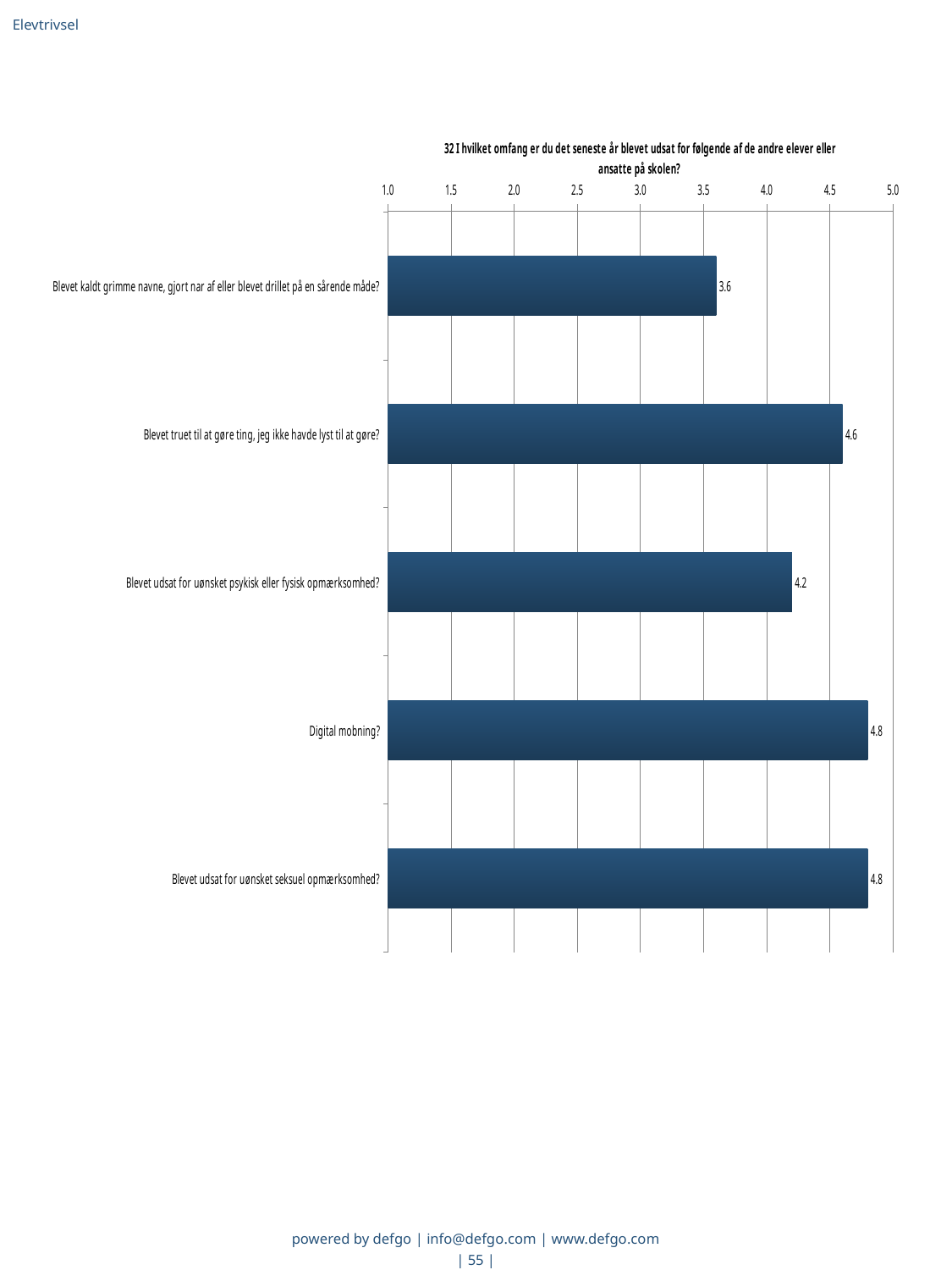
What is the value for "Digital mobning?"? 4.8 How many categories are shown in the chart? 5 Which is larger: the value for "Blevet truet til at gøre ting, jeg ikke havde lyst til at gøre?" or the value for "Blevet udsat for uønsket psykisk eller fysisk opmærksomhed?"? Blevet truet til at gøre ting, jeg ikke havde lyst til at gøre? What is the difference between the values for "Digital mobning?" and "Blevet kaldt grimme navne, gjort nar af eller blevet drillet på en sårende måde?"? 1.2 Is the value for "Blevet udsat for uønsket psykisk eller fysisk opmærksomhed?" greater or less than 4.0? greater What is the value for "Blevet udsat for uønsket seksuel opmærksomhed?"? 4.8 Which category has the lowest value? Blevet kaldt grimme navne, gjort nar af eller blevet drillet på en sårende måde? What is the value for "Blevet truet til at gøre ting, jeg ikke havde lyst til at gøre?"? 4.6 What is the title of the chart? 32 I hvilket omfang er du det seneste år blevet udsat for følgende af de andre elever eller ansatte på skolen? What is the value for "Blevet udsat for uønsket psykisk eller fysisk opmærksomhed?"? 4.2 What kind of chart is shown on the slide? bar chart What is the value for "Blevet kaldt grimme navne, gjort nar af eller blevet drillet på en sårende måde?"? 3.6